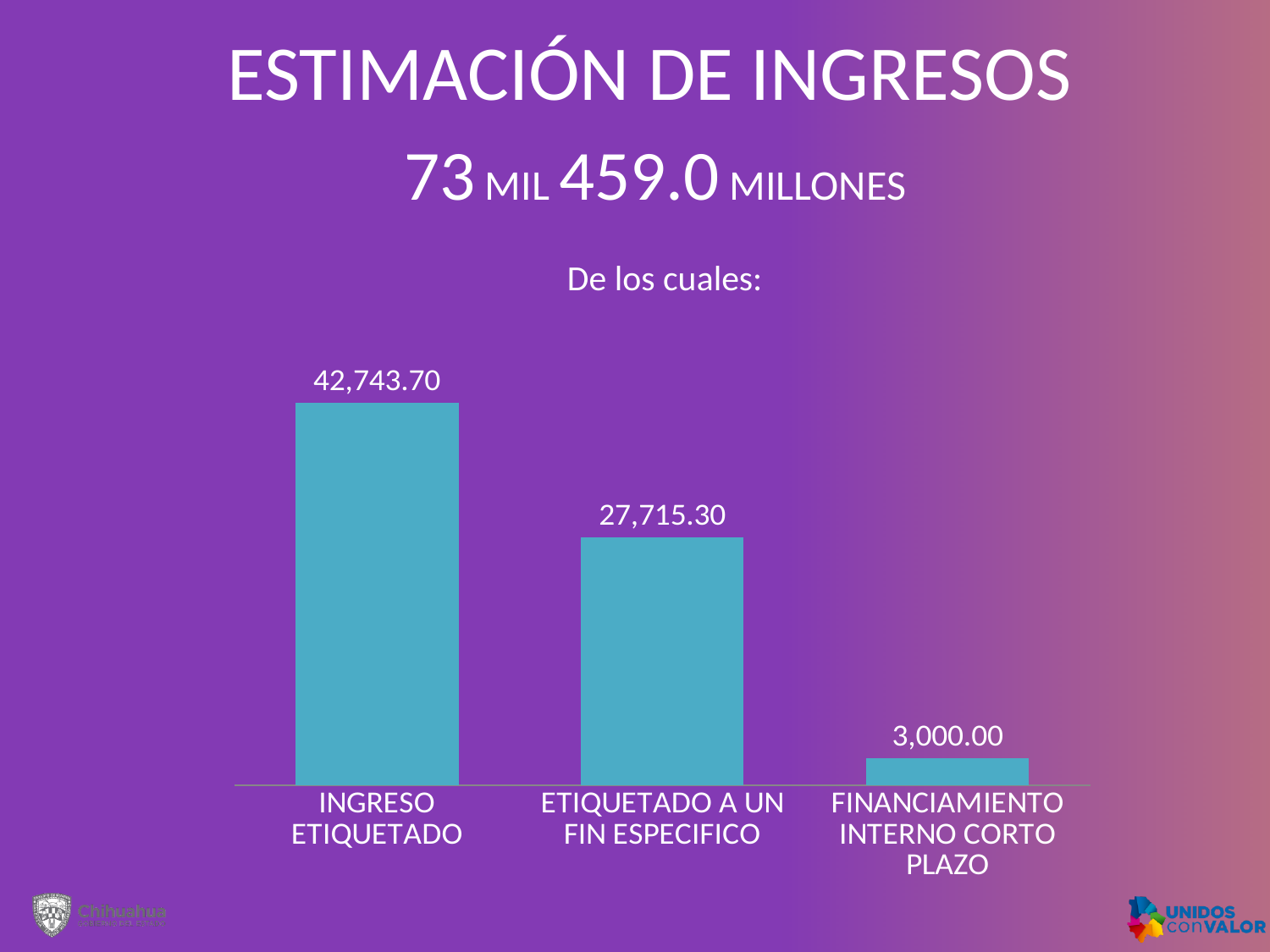
What is the title of the slide containing the chart? ESTIMACIÓN DE INGRESOS Which is larger, the value for ETIQUETADO A UN FIN ESPECIFICO or the value for FINANCIAMIENTO INTERNO CORTO PLAZO? ETIQUETADO A UN FIN ESPECIFICO What is the difference between the values for INGRESO ETIQUETADO and ETIQUETADO A UN FIN ESPECIFICO? 15,028.40 What is the difference between the values for ETIQUETADO A UN FIN ESPECIFICO and FINANCIAMIENTO INTERNO CORTO PLAZO? 24,715.30 Which category has the lowest value? FINANCIAMIENTO INTERNO CORTO PLAZO What is the value for FINANCIAMIENTO INTERNO CORTO PLAZO? 3,000.00 How many categories are shown in the chart? 3 What is the value for ETIQUETADO A UN FIN ESPECIFICO? 27,715.30 Which category has the highest value? INGRESO ETIQUETADO What kind of chart is shown on the slide? Bar chart What is the value for INGRESO ETIQUETADO? 42,743.70 Do the values rise or fall from left to right across the categories? Fall